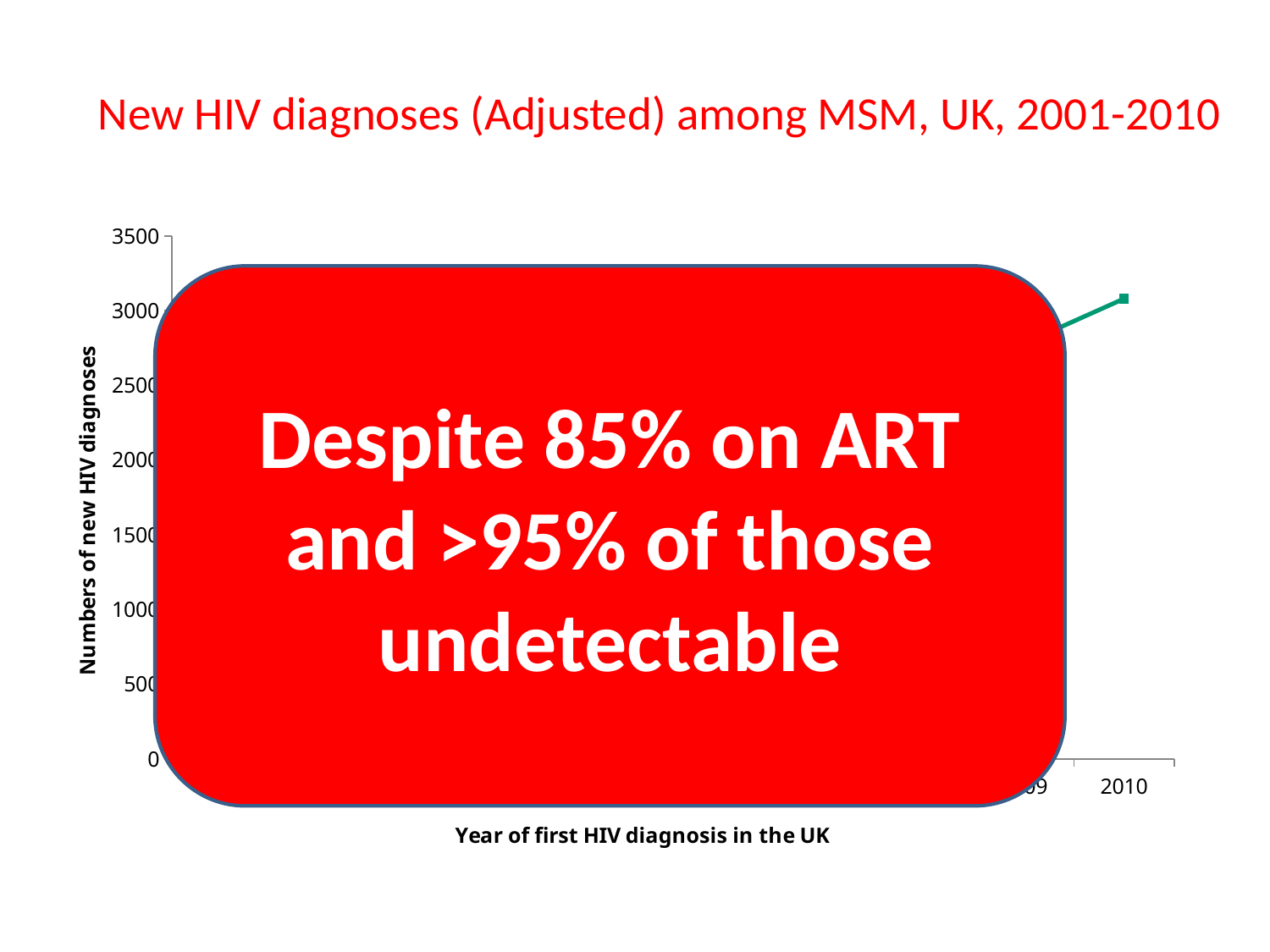
What is the title of the chart? New HIV diagnoses (Adjusted) among MSM, UK, 2001-2010 Is the value for 2010 greater or less than 3500? less Is the value for 2010 greater or less than 2500? greater Does the line rise or fall as it approaches 2010 on the x axis? rises What kind of chart is shown on the slide? line chart What is the label of the x axis? Year of first HIV diagnosis in the UK